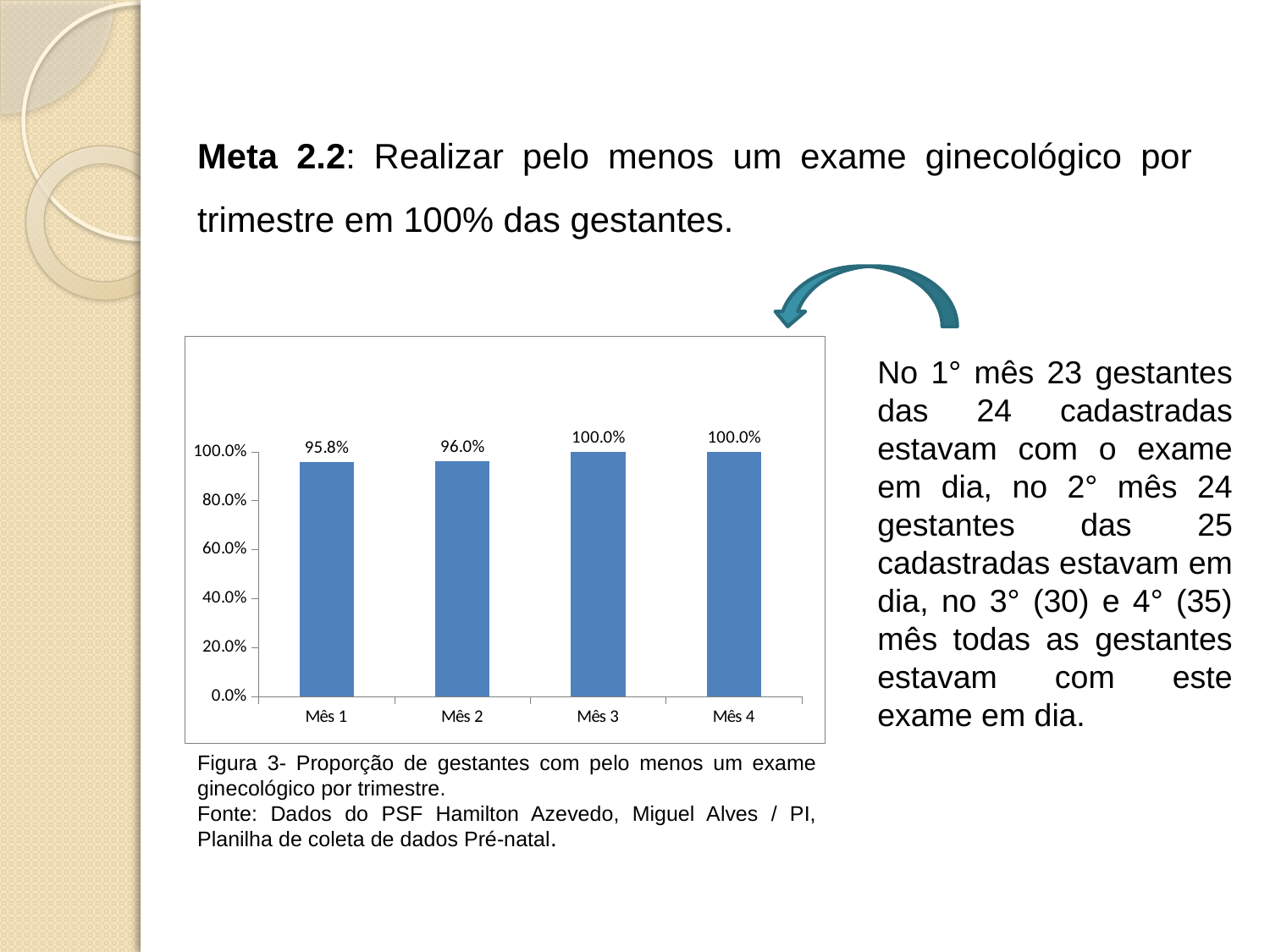
Is the value for Mês 1 greater or less than 80.0%? greater What is the value for Mês 1? 95.8% What is the difference between the values for Mês 3 and Mês 1? 4.2% Do the values rise or fall from Mês 1 to Mês 4? rise Which is larger, the value for Mês 2 or the value for Mês 3? Mês 3 What is the difference between the values for Mês 2 and Mês 1? 0.2% What is the value for Mês 4? 100.0% What is the value for Mês 3? 100.0% What is the value for Mês 2? 96.0% How many months are shown on the x axis? 4 Which month has the lowest value? Mês 1 What kind of chart is shown on the slide? bar chart